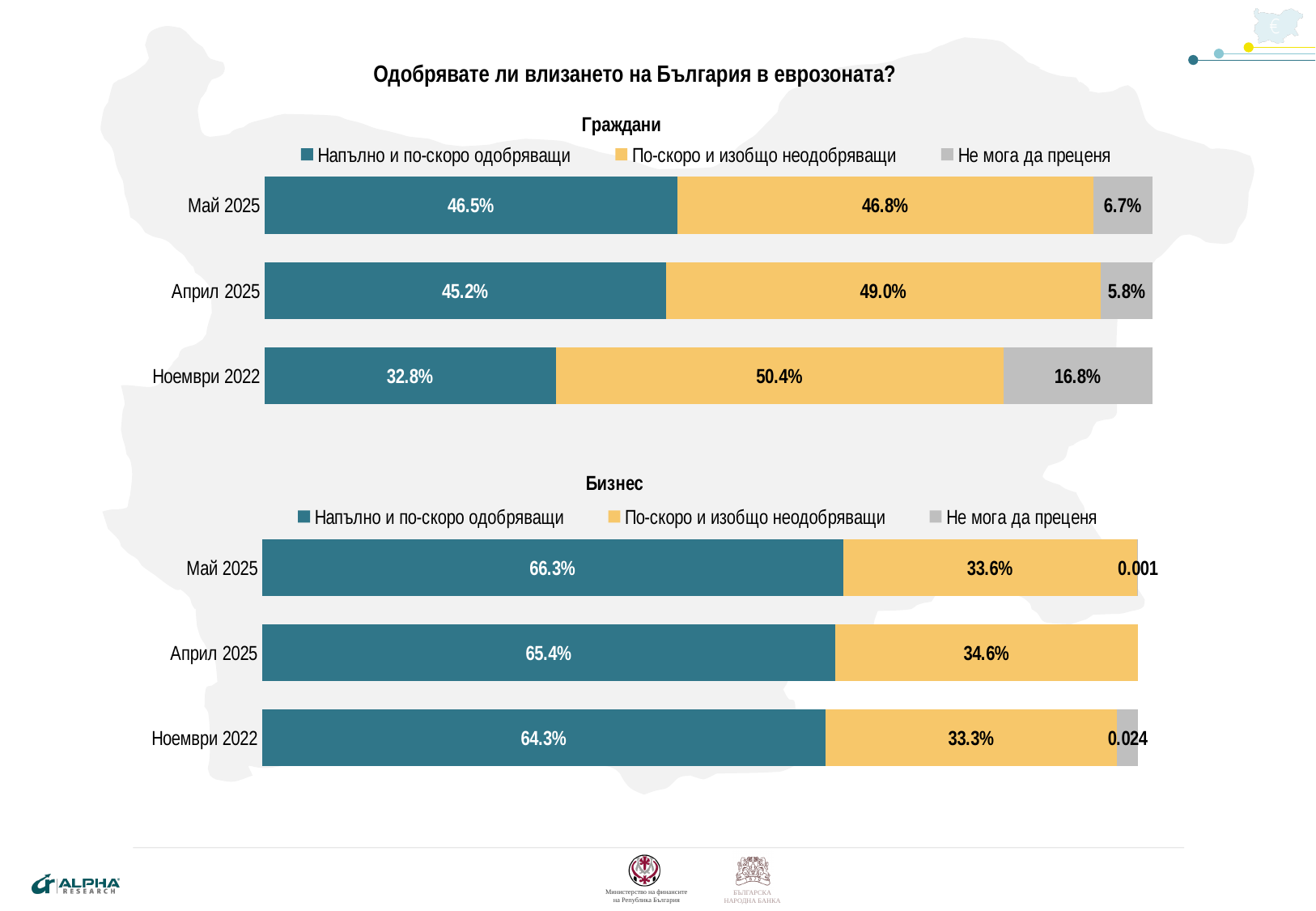
In the Граждани chart, which period has the highest value for Напълно и по-скоро одобряващи? Май 2025 In the Граждани chart, does the share of Напълно и по-скоро одобряващи rise or fall from Ноември 2022 to Май 2025? Rise In the Граждани chart, what is the difference between the Напълно и по-скоро одобряващи values for Май 2025 and Ноември 2022? 13.7 percentage points In the Бизнес chart, what is the value for Напълно и по-скоро одобряващи in Май 2025? 66.3% In the Бизнес chart, which is larger: the Напълно и по-скоро одобряващи value for Май 2025 or for Ноември 2022? Май 2025 In the Граждани chart, what is the value for Напълно и по-скоро одобряващи in Май 2025? 46.5% What kind of chart is the Граждани chart? Stacked bar chart In the Граждани chart, which period has the lowest value for Не мога да преценя? Април 2025 How many periods are shown in the Граждани chart? 3 How many series does the legend of the Бизнес chart list? 3 In the Бизнес chart, what is the value for По-скоро и изобщо неодобряващи in Април 2025? 34.6% In the Граждани chart, what is the value for Не мога да преценя in Ноември 2022? 16.8%